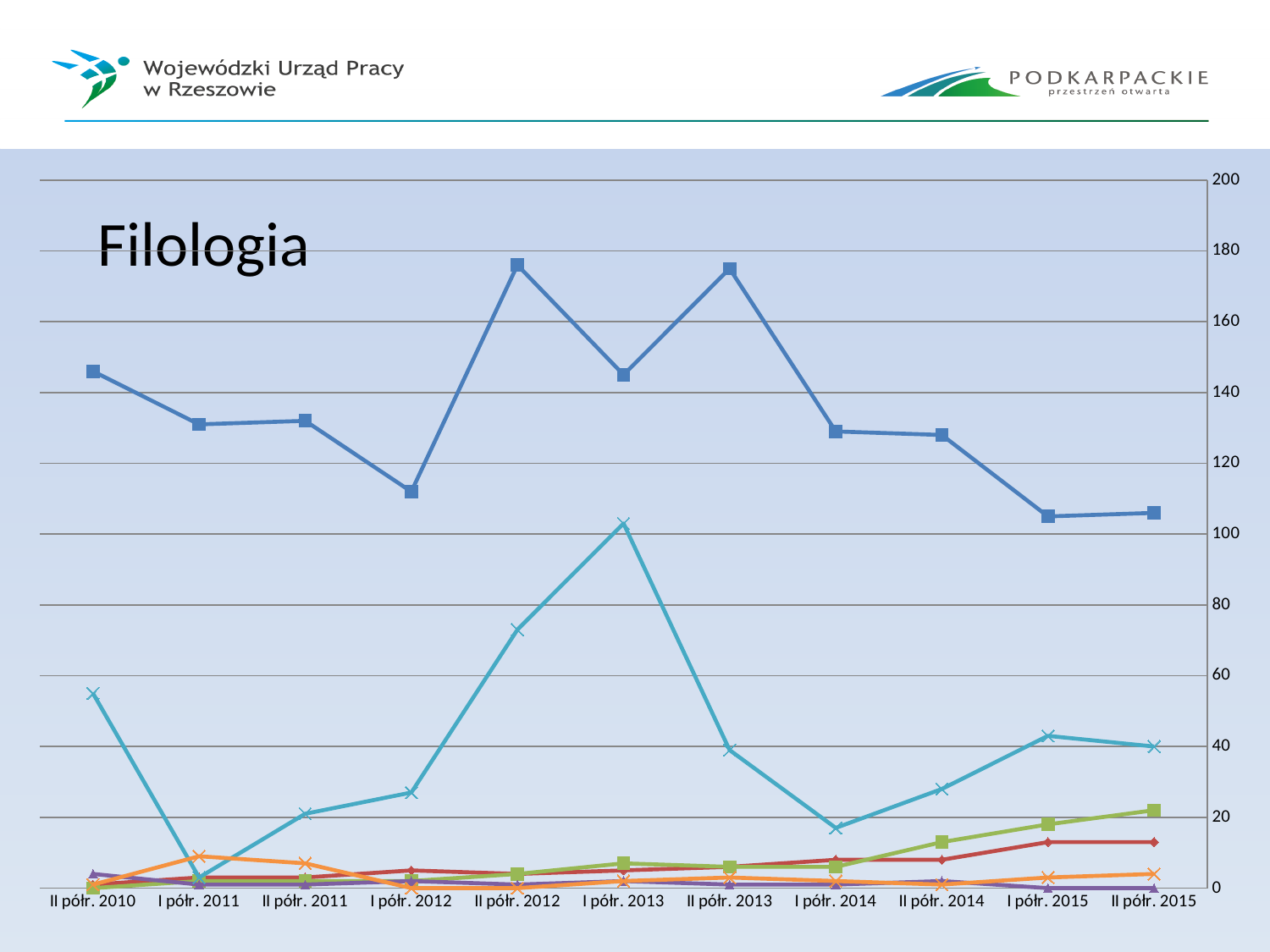
Is the value of the blue line with square markers at II półr. 2012 greater or less than 160? greater What is the maximum value shown on the vertical axis? 200 What is the title of the chart? Filologia At which period does the teal line with x markers reach its lowest value? I półr. 2011 For the blue line with square markers, which period has the higher value: II półr. 2010 or I półr. 2012? II półr. 2010 Is the value of the blue line with square markers at I półr. 2015 greater or less than 120? less What kind of chart is shown on the slide? line chart Is the value of the blue line with square markers at I półr. 2012 greater or less than 120? less Does the blue line with square markers rise or fall from II półr. 2013 to I półr. 2015? fall At which period does the teal line with x markers reach its highest value? I półr. 2013 How many time periods are shown on the x axis? 11